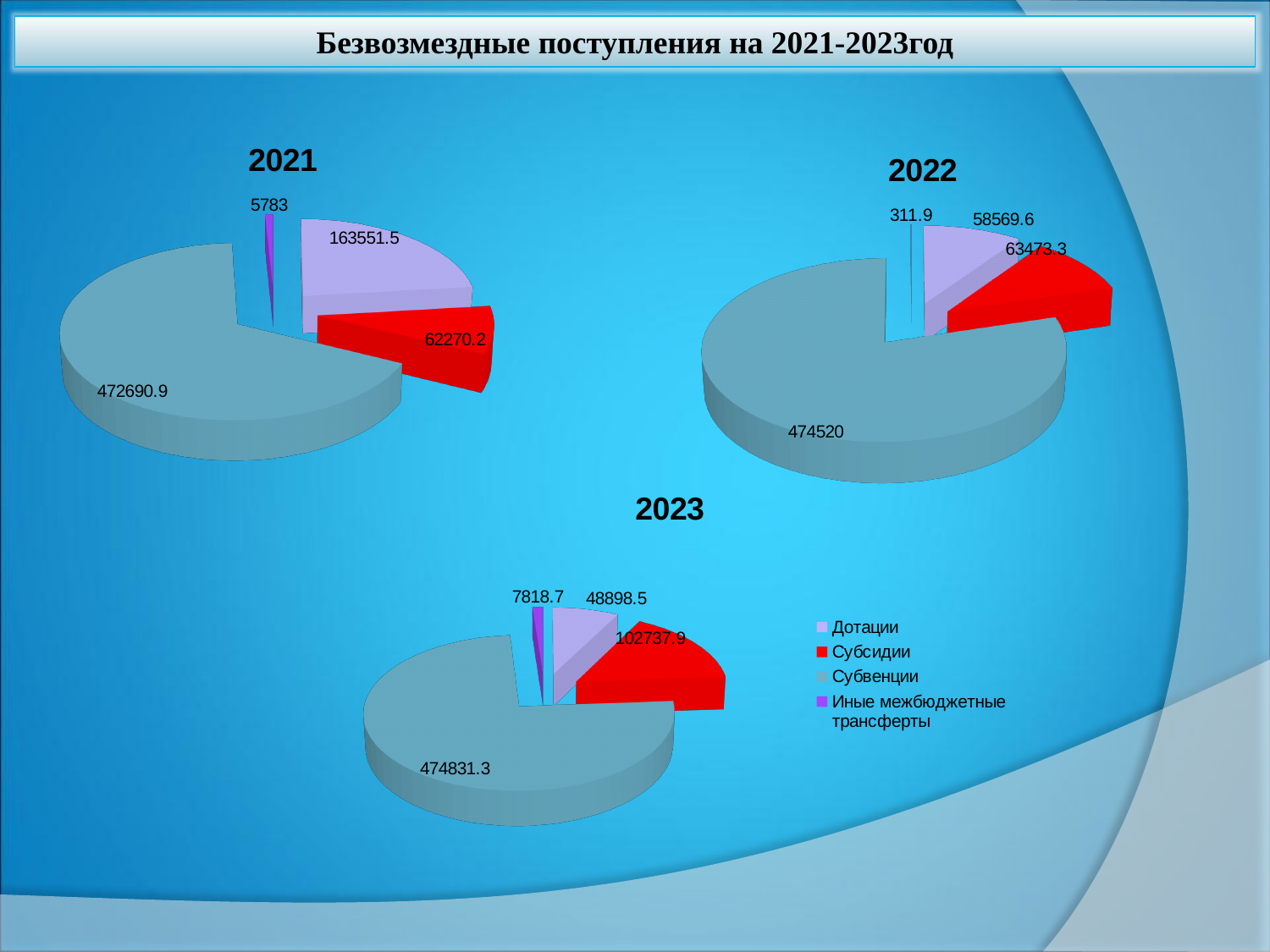
In the 2023 chart, what is the value for Субсидии? 102737.9 In the 2022 chart, what is the value for Иные межбюджетные трансферты? 311.9 In the 2021 chart, which category has the smallest value? Иные межбюджетные трансферты Which colour represents Субсидии in the legend? Red How many categories does the legend list? 4 In the 2023 chart, what is the difference between Субсидии and Дотации? 53839.4 In the 2023 chart, which category has the largest value? Субвенции In the 2021 chart, which is larger, Дотации or Субсидии? Дотации In the 2022 chart, what is the difference between Субсидии and Дотации? 4903.7 What type of chart is used for the 2021 data? Pie chart In the 2021 chart, what is the value for Субвенции? 472690.9 How many slices does the 2022 pie chart have? 4